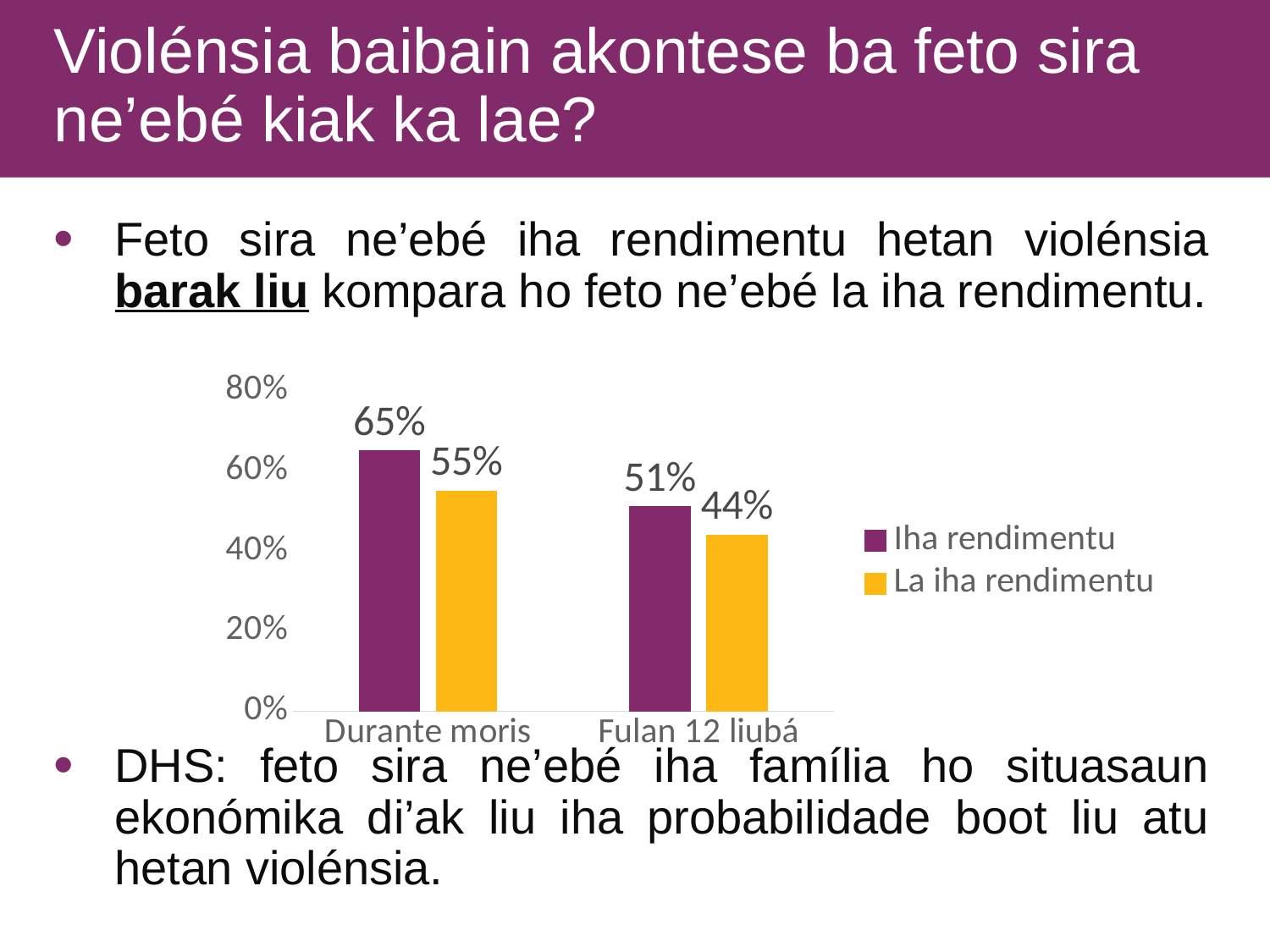
How many series does the chart's legend list? 2 What is the difference between "Iha rendimentu" and "La iha rendimentu" in the "Fulan 12 liubá" category? 7% What kind of chart is shown on the slide? Bar chart Which category has the lowest value for "La iha rendimentu"? Fulan 12 liubá What is the value for "La iha rendimentu" in the "Fulan 12 liubá" category? 44% What is the value for "La iha rendimentu" in the "Durante moris" category? 55% How many categories are shown on the x axis of the chart? 2 In the "Fulan 12 liubá" category, which series has the larger value, "Iha rendimentu" or "La iha rendimentu"? Iha rendimentu Which category has the highest value for "Iha rendimentu"? Durante moris What is the value for "Iha rendimentu" in the "Fulan 12 liubá" category? 51% What is the difference between "Iha rendimentu" and "La iha rendimentu" in the "Durante moris" category? 10% What is the value for "Iha rendimentu" in the "Durante moris" category? 65%